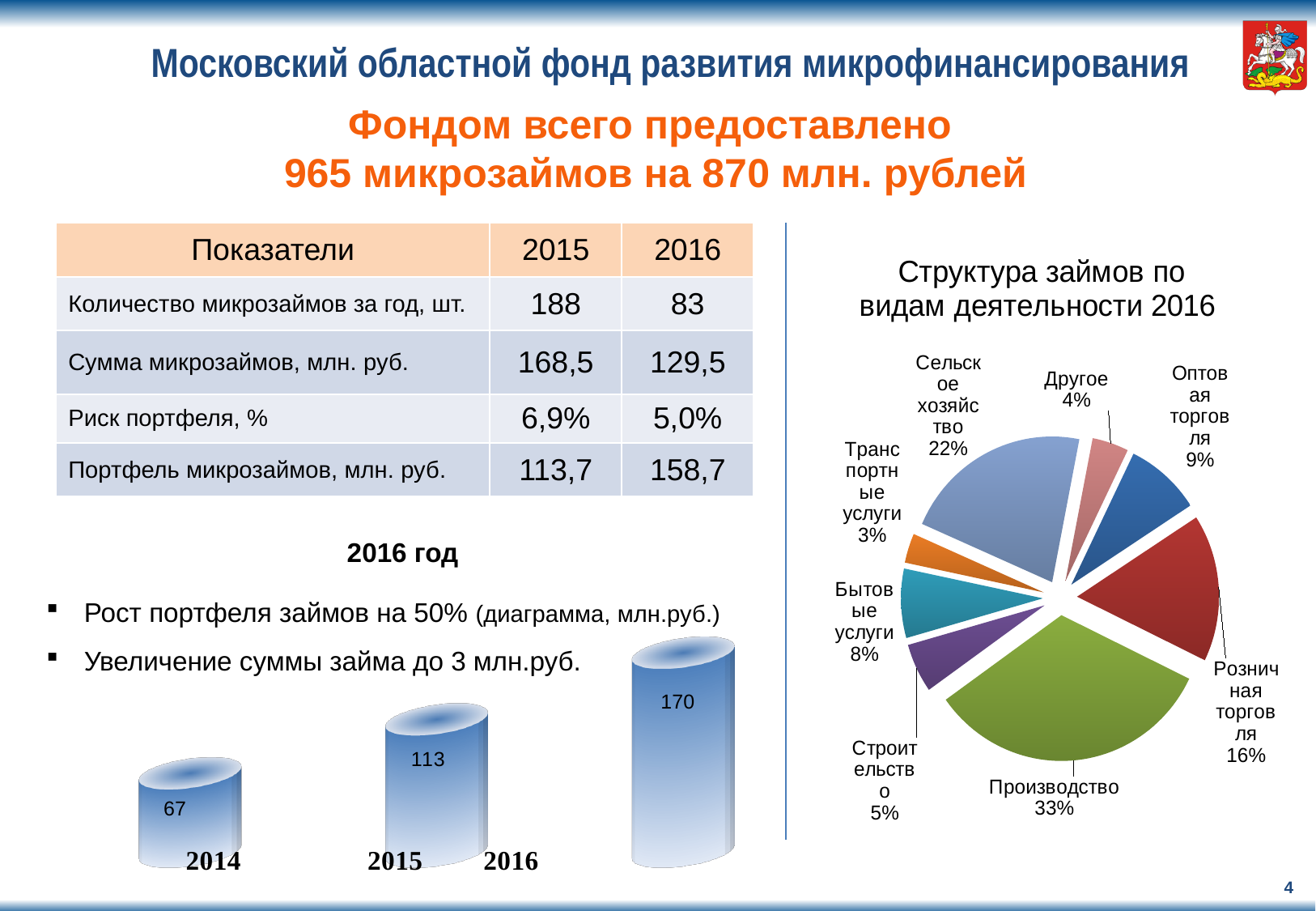
What kind of chart is shown at the bottom left of the slide? bar chart In the bar chart at the bottom left, do the values rise or fall from 2014 to 2016? rise In the bar chart at the bottom left, which year has the lowest value? 2014 In the bar chart at the bottom left, what is the value for 2014? 67 In the pie chart 'Структура займов по видам деятельности 2016', how many slices are there? 8 In the bar chart at the bottom left, what is the value for 2016? 170 In the pie chart 'Структура займов по видам деятельности 2016', what share does Производство have? 33% In the pie chart 'Структура займов по видам деятельности 2016', which is larger: Розничная торговля or Оптовая торговля? Розничная торговля In the pie chart 'Структура займов по видам деятельности 2016', what is the difference between the shares of Сельское хозяйство and Бытовые услуги? 14% In the bar chart at the bottom left, what is the difference between the values for 2016 and 2015? 57 In the bar chart at the bottom left, how many bars are shown? 3 In the pie chart 'Структура займов по видам деятельности 2016', which category has the smallest share? Транспортные услуги